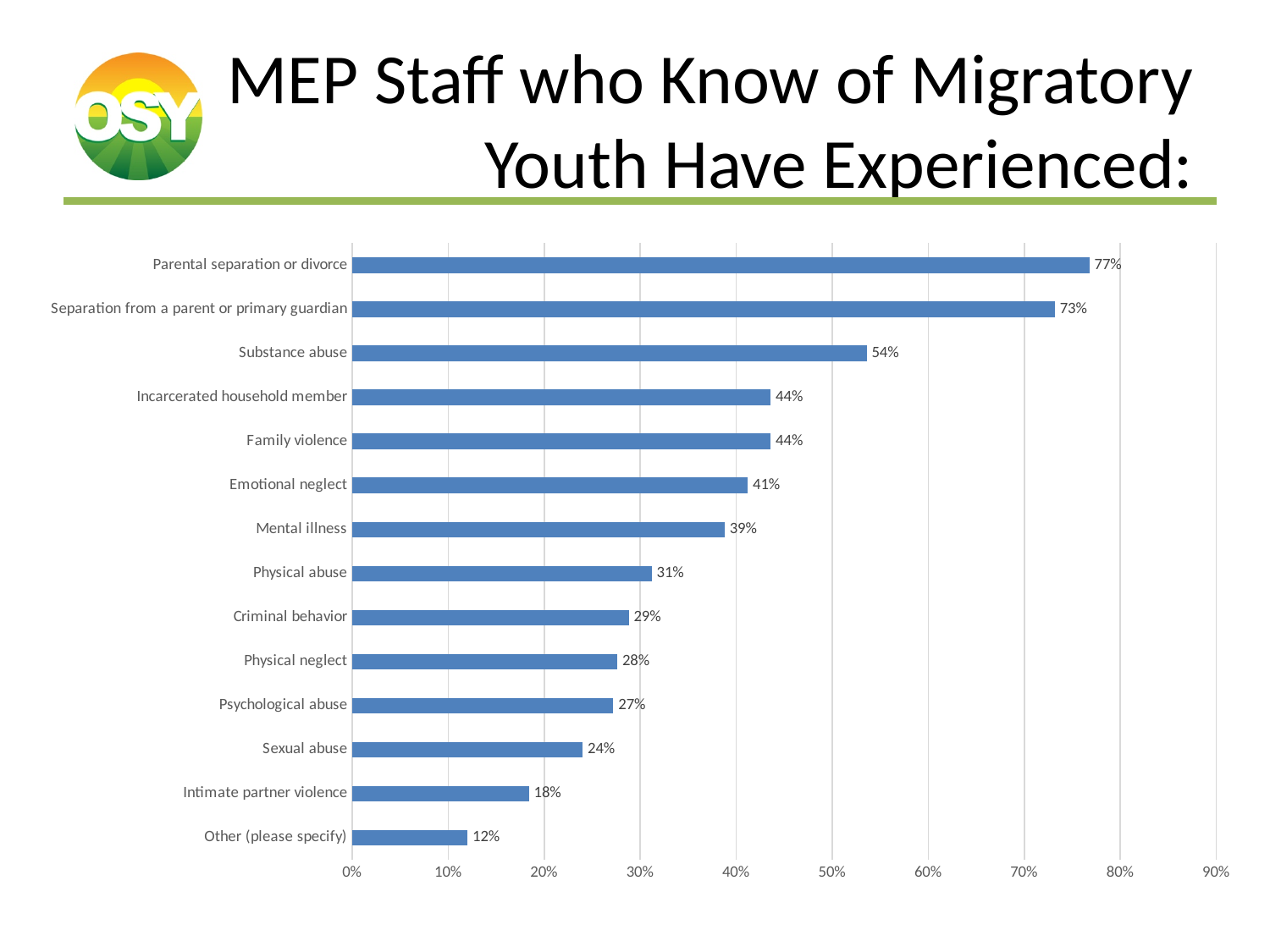
What kind of chart is shown on the slide? Bar chart What is the difference between Parental separation or divorce and Separation from a parent or primary guardian? 4% What percentage is shown for Mental illness? 39% Which is larger, Emotional neglect or Physical neglect? Emotional neglect Which is larger, Physical abuse or Criminal behavior? Physical abuse What is the highest value shown on the horizontal axis? 90% What is the difference between Substance abuse and Sexual abuse? 30% Which category has the highest value? Parental separation or divorce What percentage is shown for Substance abuse? 54% Which category has the lowest value? Other (please specify) What is the value for Intimate partner violence? 18% How many categories are shown in the chart? 14